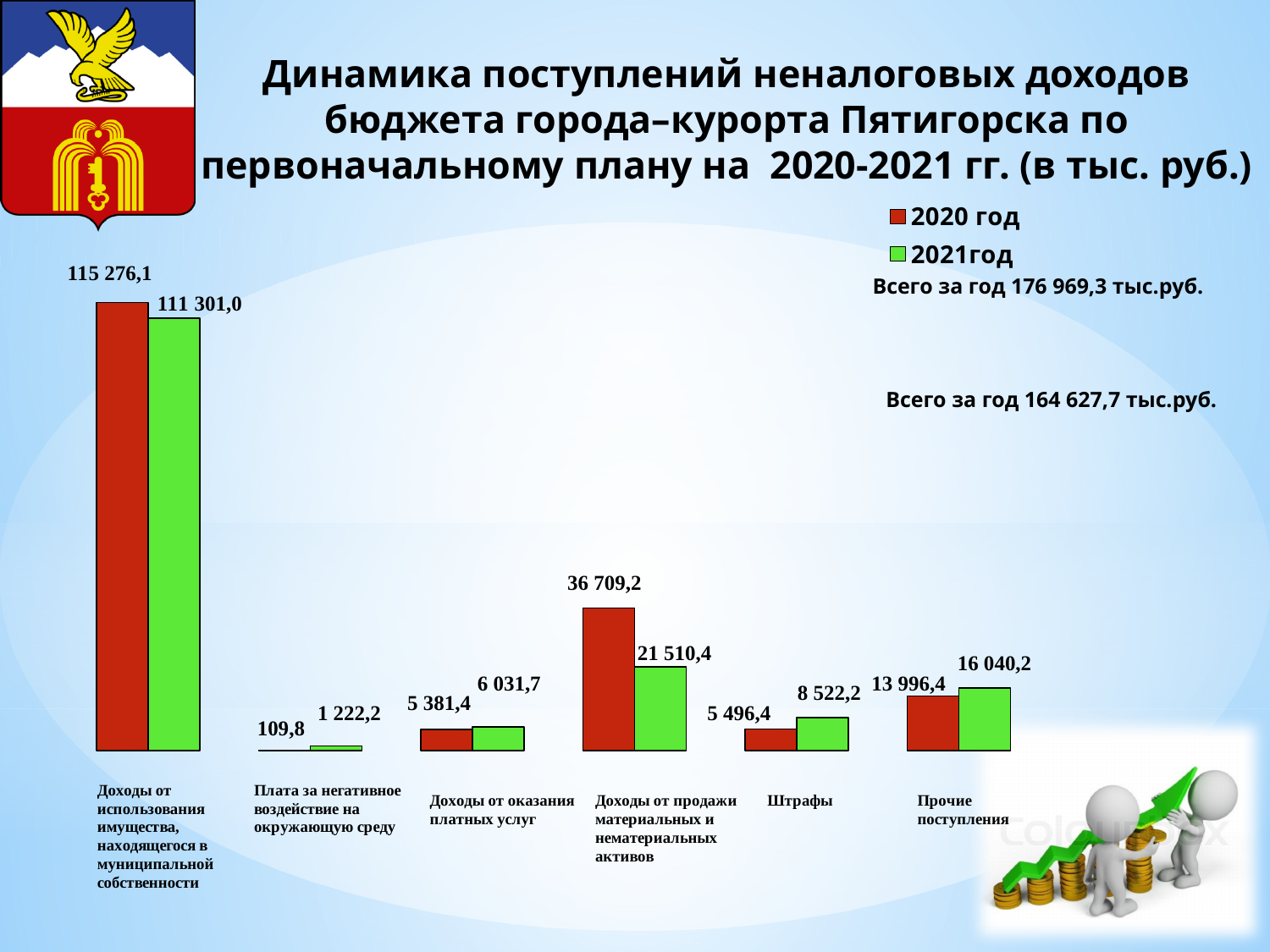
What is the 2021год value for Доходы от оказания платных услуг? 6 031,7 How many categories are shown on the x axis of the chart? 6 Which colour represents the 2021год series in the chart? green Which category has the highest 2020 год value? Доходы от использования имущества, находящегося в муниципальной собственности What is the 2020 год value for Штрафы? 5 496,4 For Прочие поступления, which is larger: the 2020 год value or the 2021год value? 2021год Which category has the lowest 2021год value? Плата за негативное воздействие на окружающую среду How many series does the legend list? 2 What type of chart is shown on the slide? bar chart What is the difference between the 2020 год and 2021год values for Доходы от продажи материальных и нематериальных активов? 15 198,8 What is the 2020 год value for Доходы от продажи материальных и нематериальных активов? 36 709,2 What is the 2021год value for Плата за негативное воздействие на окружающую среду? 1 222,2